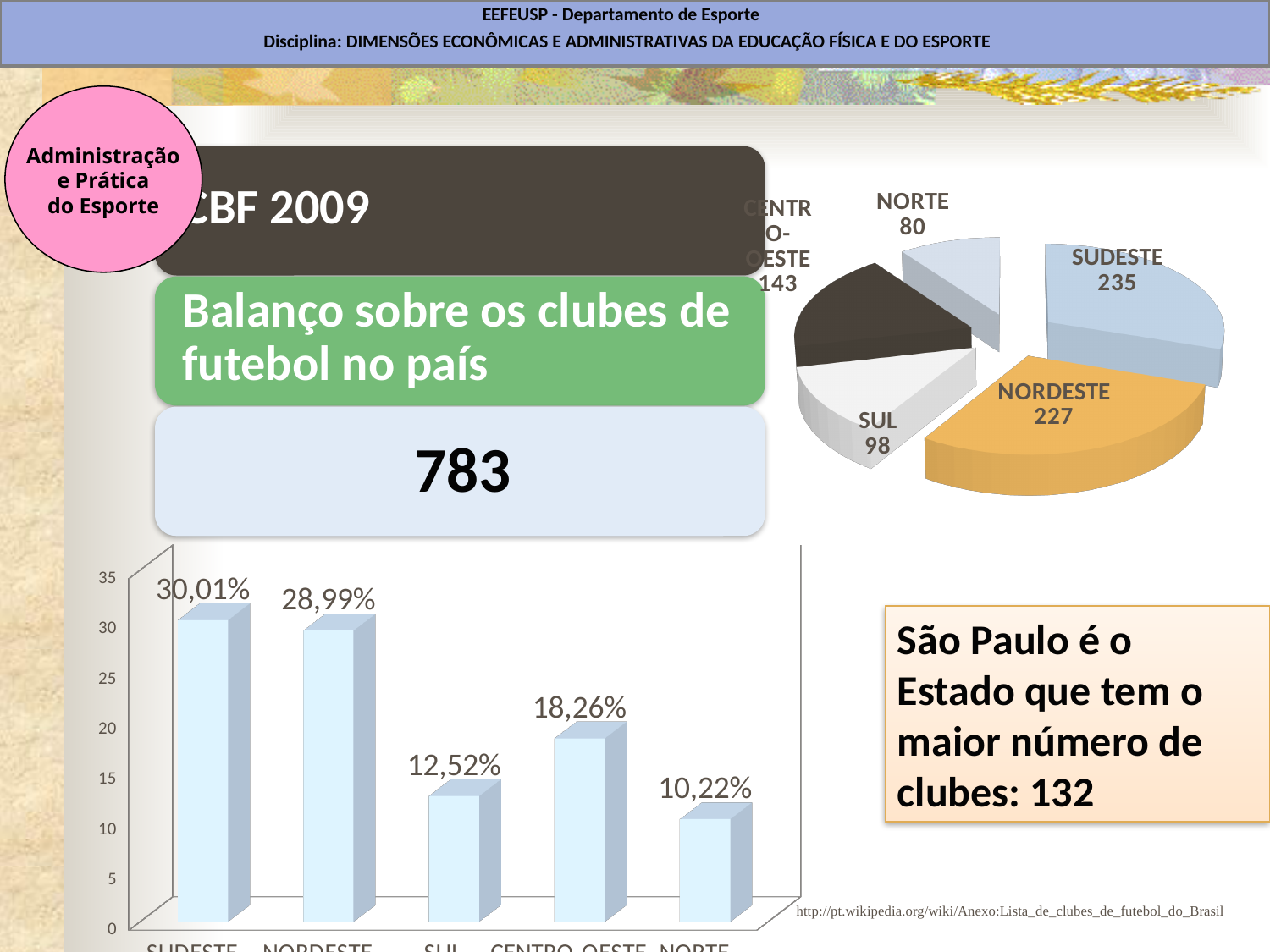
In the bar chart at the bottom left, which is larger, the value for SUL or the value for CENTRO-OESTE? CENTRO-OESTE In the pie chart, how many clubs are shown for NORDESTE? 227 In the pie chart, what is the difference between the SUDESTE and NORDESTE values? 8 In the bar chart at the bottom left, what is the value of the lowest bar? 10,22% In the pie chart, which region has the largest slice? SUDESTE In the bar chart at the bottom left, what is the value of the first (leftmost) bar? 30,01% In the pie chart, what value is shown for CENTRO-OESTE? 143 In the pie chart, what value is shown for SUL? 98 In the pie chart, which region has the smallest slice? NORTE What kind of chart is the chart at the bottom left of the slide? Bar chart What kind of chart is the chart in the top right of the slide? Pie chart How many slices does the pie chart have? 5